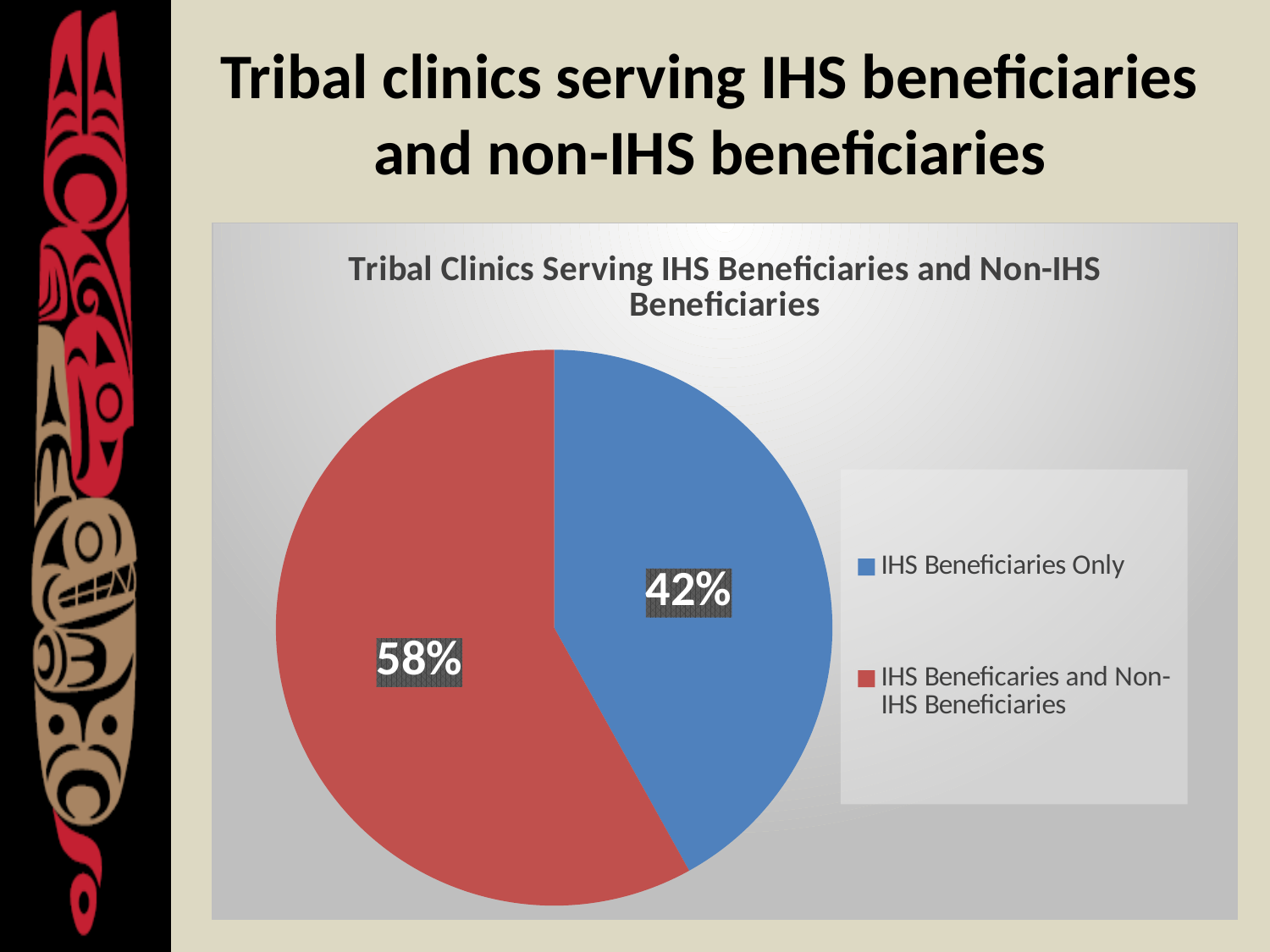
Which slice of the pie is the largest? IHS Beneficaries and Non-IHS Beneficiaries Which slice of the pie is the smallest? IHS Beneficiaries Only What kind of chart is shown on the slide? pie chart What is the title of the chart? Tribal Clinics Serving IHS Beneficiaries and Non-IHS Beneficiaries How many entries does the legend list? 2 Which is larger: the share for IHS Beneficiaries Only or the share for IHS Beneficaries and Non-IHS Beneficiaries? IHS Beneficaries and Non-IHS Beneficiaries What share of the pie is labelled "IHS Beneficaries and Non-IHS Beneficiaries"? 58% What is the difference in percentage points between the two slices of the pie? 16 What colour is the slice for IHS Beneficiaries Only? blue How many slices does the pie chart have? 2 What share of the pie is labelled "IHS Beneficiaries Only"? 42%